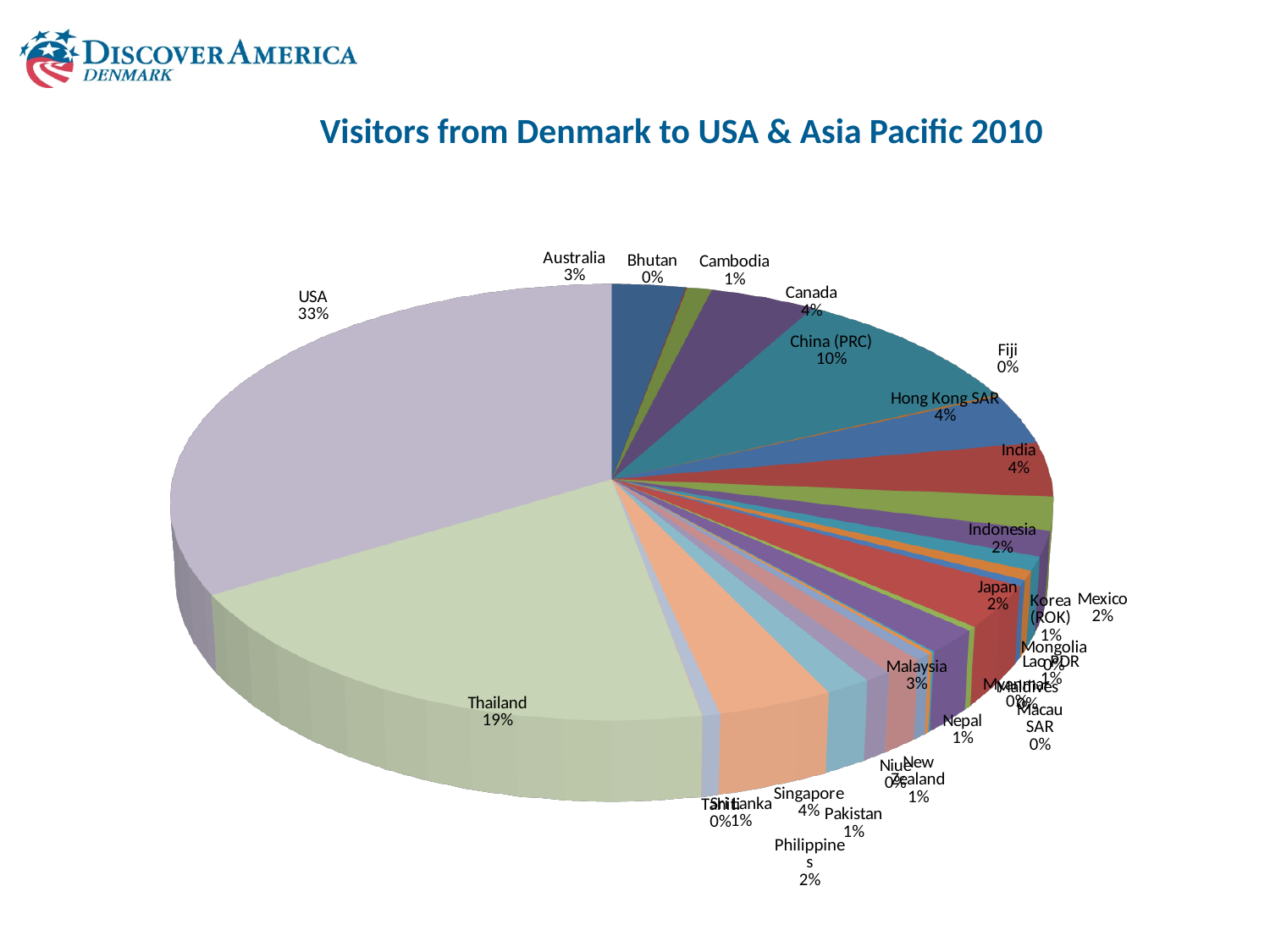
What is the difference in percentage points between the USA and Thailand slices? 14 Which has a larger share, Thailand or Hong Kong SAR? Thailand What percentage is shown for China (PRC)? 10% Which destination has the largest slice of the pie? USA What is the title of the chart? Visitors from Denmark to USA & Asia Pacific 2010 Which has a larger share, China (PRC) or Canada? China (PRC) What type of chart is shown on the slide? Pie chart What percentage is shown for Australia? 3% What percentage is shown for Thailand? 19% What percentage is shown for Canada? 4% What share of visitors does the USA account for in the pie chart? 33% What percentage is shown for Malaysia? 3%